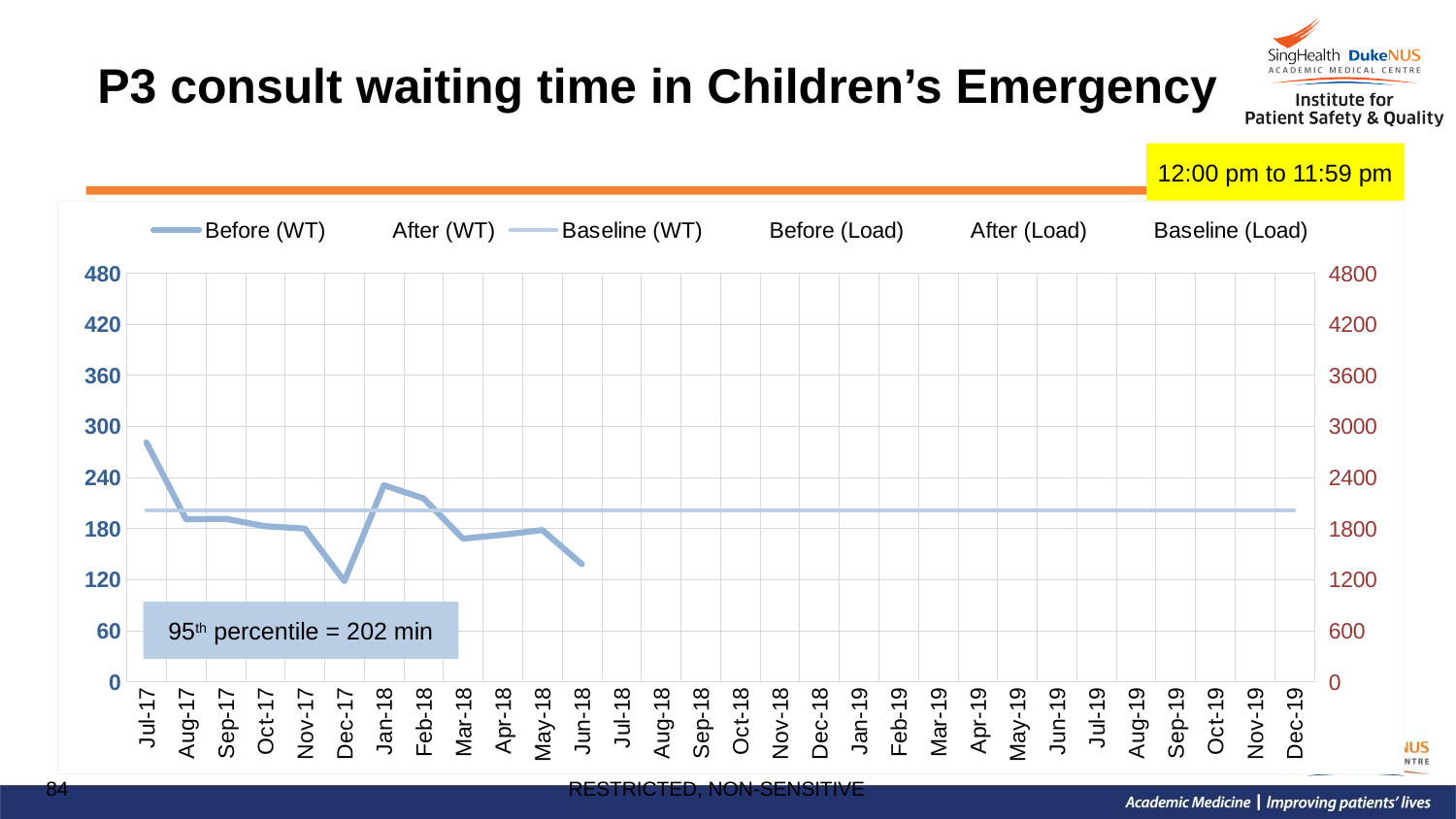
How many series does the legend list? 6 Is the Before (WT) value for Dec-17 greater or less than 180? less Is the Before (WT) value for Jul-17 greater or less than 240? greater Is the Before (WT) value for Jan-18 greater or less than 180? greater What is the 95th percentile value stated in the text box on the chart? 202 min Which is larger, the Before (WT) value for Jul-17 or for Jan-18? Jul-17 How many months are labelled along the x axis? 30 Do the Before (WT) values rise or fall from Jul-17 to Dec-17? fall What time window is shown in the yellow highlighted box above the chart? 12:00 pm to 11:59 pm Which month has the lowest Before (WT) value? Dec-17 Which month has the highest Before (WT) value? Jul-17 What kind of chart is shown on the slide? line chart